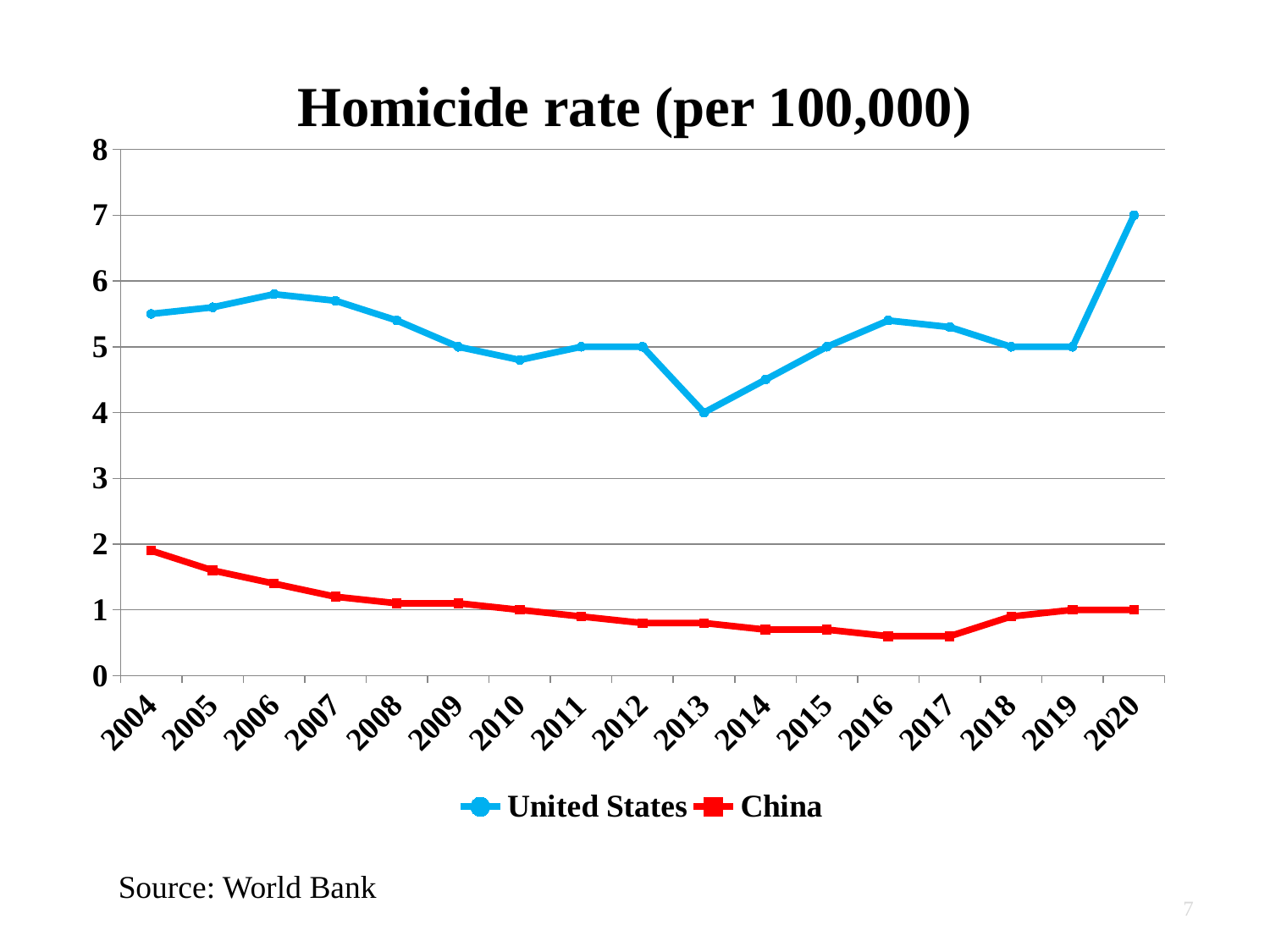
In which year is the United States homicide rate lowest? 2013 What is the homicide rate for China in 2020? 1 What is the homicide rate for the United States in 2013? 4 What kind of chart is shown on the slide? line chart What is the homicide rate for the United States in 2020? 7 How many years are plotted along the x axis? 17 What is the title of the chart? Homicide rate (per 100,000) In which year is the United States homicide rate highest? 2020 Which series has the higher homicide rate in 2010, United States or China? United States How many series does the legend list? 2 Does the homicide rate for China rise or fall from 2004 to 2012? fall